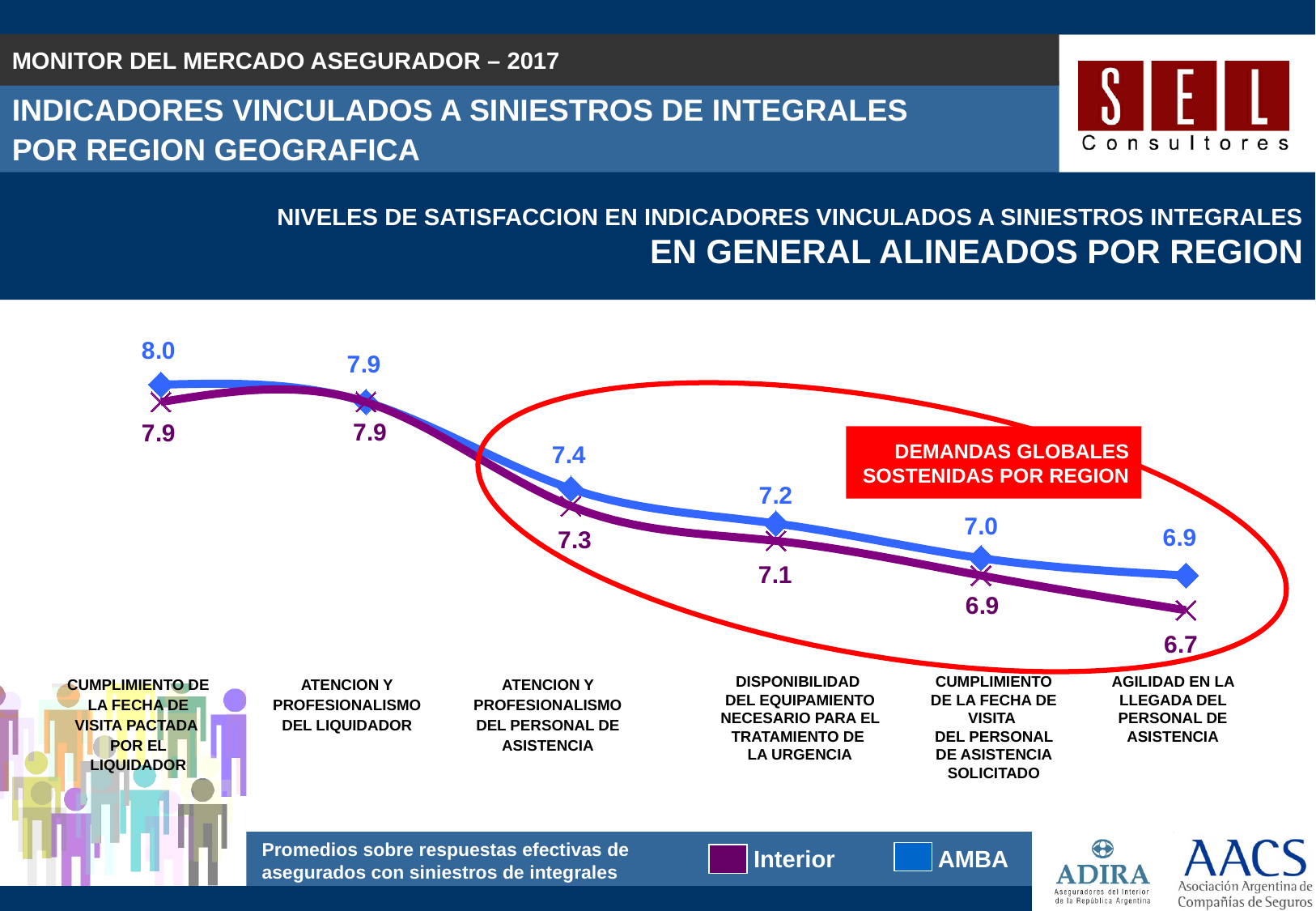
How many series does the legend list? 2 How many categories are shown on the x axis of the chart? 6 Do the AMBA values rise or fall from left to right along the x axis? Fall What is the AMBA value for 'Cumplimiento de la fecha de visita del personal de asistencia solicitado'? 7.0 Which category has the highest AMBA value? Cumplimiento de la fecha de visita pactada por el liquidador What kind of chart is shown on the slide? Line chart Which category has the lowest Interior value? Agilidad en la llegada del personal de asistencia What is the Interior value for 'Agilidad en la llegada del personal de asistencia'? 6.7 What is the Interior value for 'Disponibilidad del equipamiento necesario para el tratamiento de la urgencia'? 7.1 Which series has the larger value for 'Atencion y profesionalismo del personal de asistencia', Interior or AMBA? AMBA What is the difference between the AMBA and Interior values for 'Agilidad en la llegada del personal de asistencia'? 0.2 What is the AMBA value for 'Cumplimiento de la fecha de visita pactada por el liquidador'? 8.0